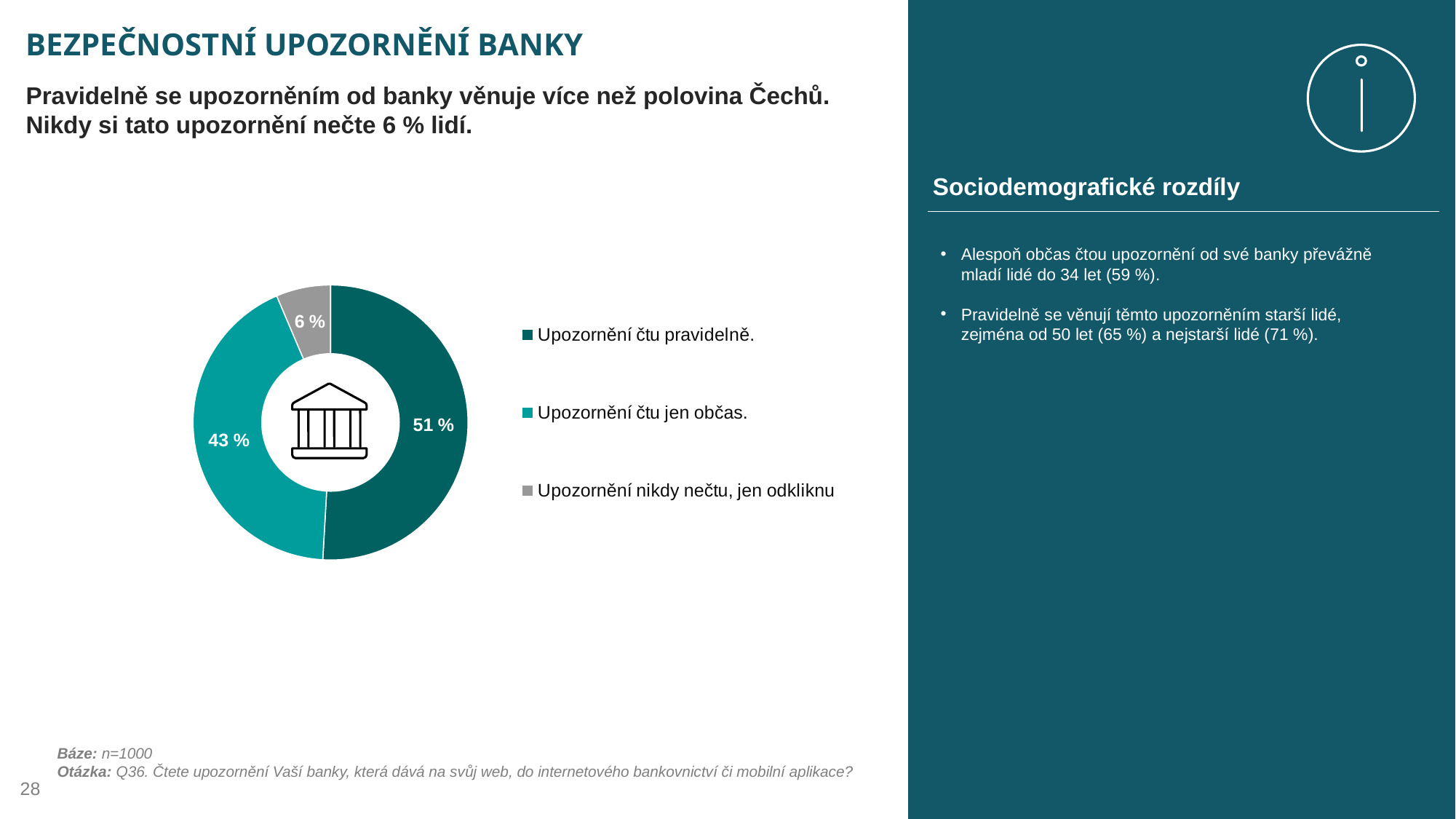
What share of respondents answered "Upozornění čtu jen občas."? 43 % What share of respondents answered "Upozornění čtu pravidelně."? 51 % Which category has the largest share of the pie? Upozornění čtu pravidelně. What colour is the slice for "Upozornění nikdy nečtu, jen odkliknu"? Grey Which category has the smallest share of the pie? Upozornění nikdy nečtu, jen odkliknu What is the base (n) stated for the chart? n=1000 What share of respondents answered "Upozornění nikdy nečtu, jen odkliknu"? 6 % How many categories does the chart show? 3 What kind of chart is shown on the slide? Pie chart (doughnut) What is the difference in percentage points between "Upozornění čtu pravidelně." and "Upozornění čtu jen občas."? 8 Which is larger: the share for "Upozornění čtu jen občas." or for "Upozornění nikdy nečtu, jen odkliknu"? Upozornění čtu jen občas. What is the combined share of respondents who read the notifications at least sometimes ("pravidelně" plus "jen občas")? 94 %